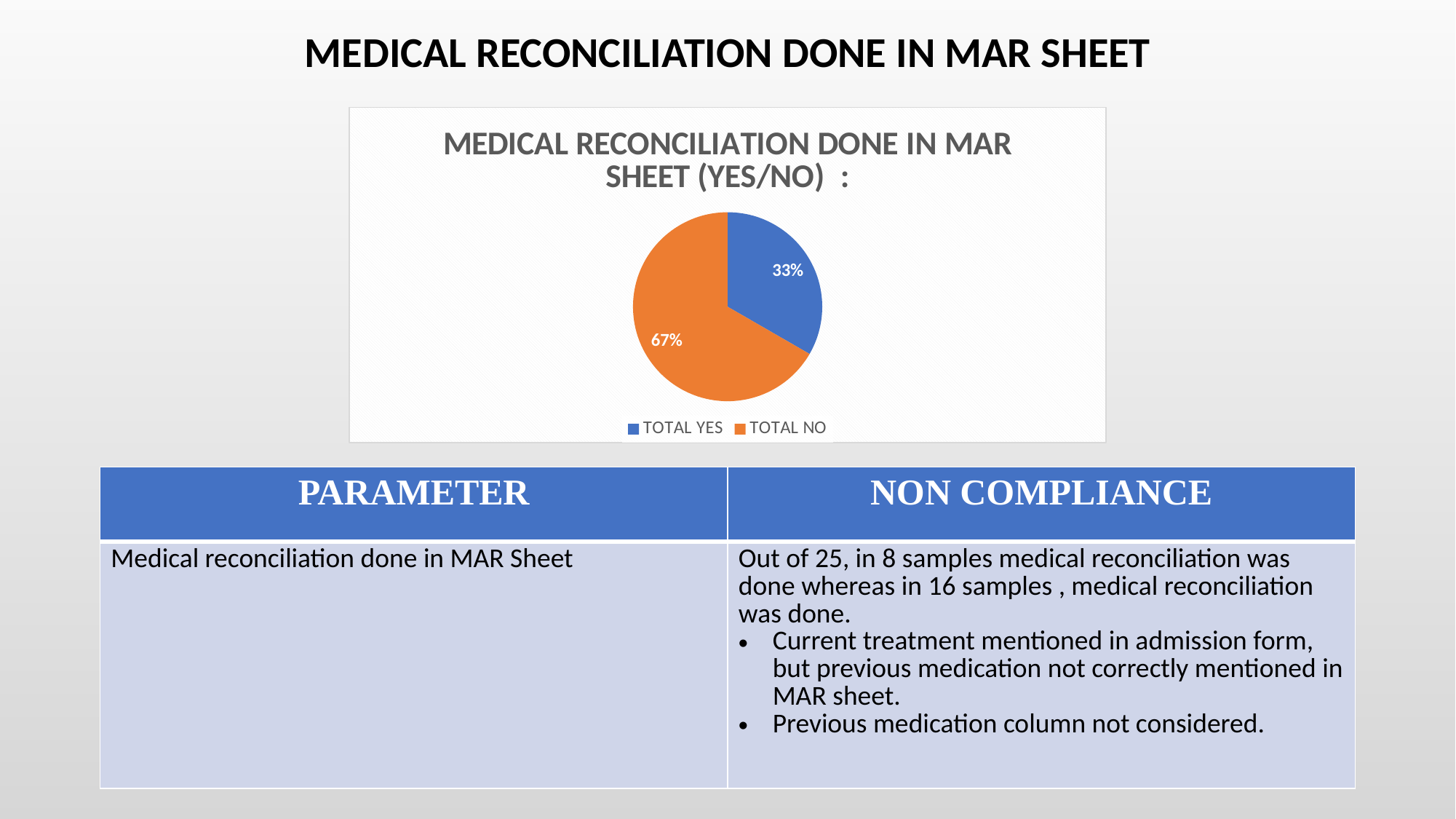
What type of chart is shown on the slide? pie chart Which slice of the pie is the smallest? TOTAL YES What percentage of the pie is TOTAL NO? 67% What is the title of the chart? MEDICAL RECONCILIATION DONE IN MAR SHEET (YES/NO) : What colour is the TOTAL NO slice? orange How many entries does the legend list? 2 How many slices does the pie chart have? 2 What percentage of the pie is TOTAL YES? 33% What is the difference in percentage points between TOTAL NO and TOTAL YES? 34 Which slice of the pie is the largest? TOTAL NO Which is larger, TOTAL YES or TOTAL NO? TOTAL NO